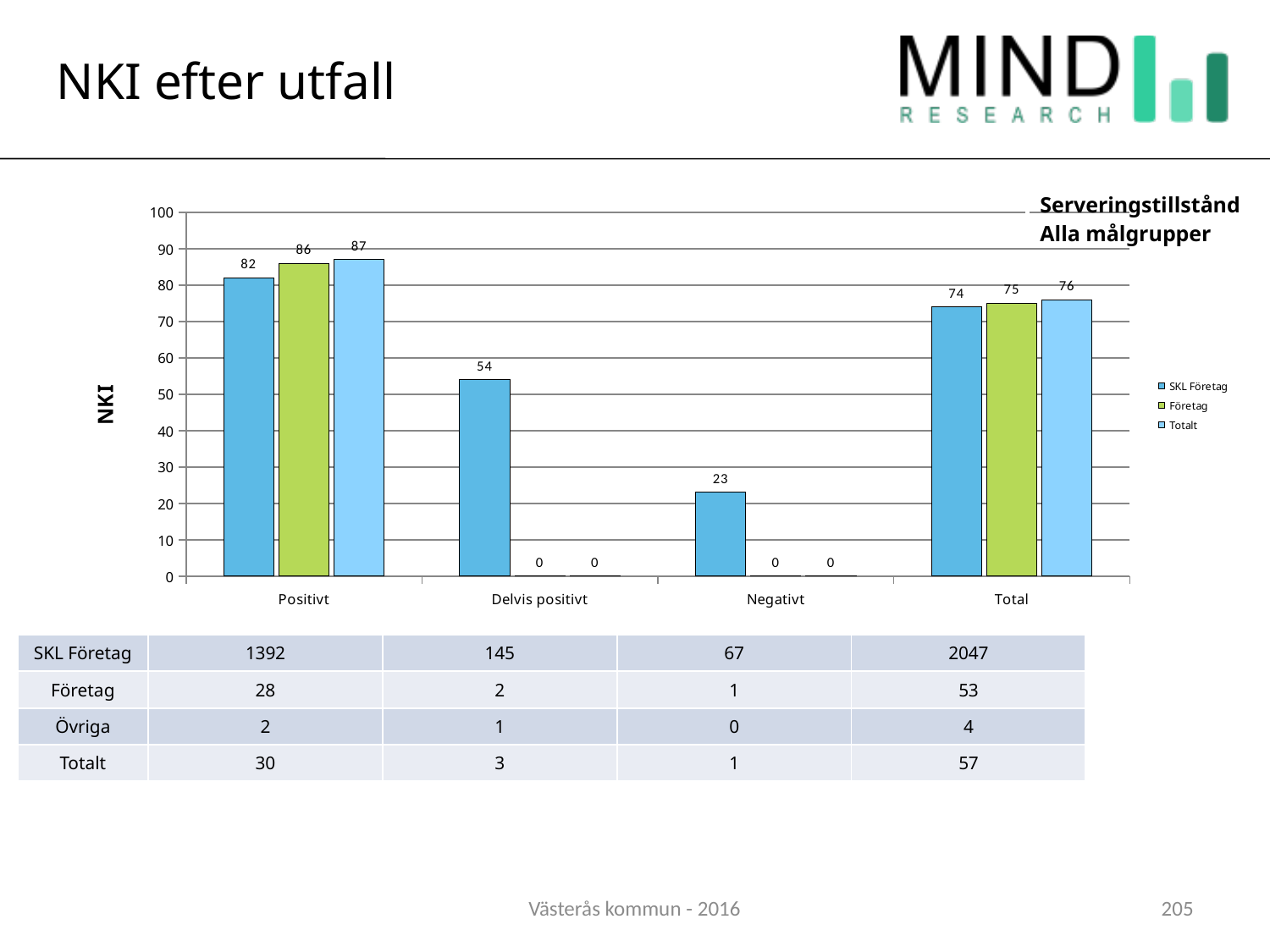
What is the difference between the Totalt value for Positivt and the Totalt value for Total? 11 What is the NKI value for SKL Företag in the Delvis positivt category? 54 What kind of chart is shown on the slide? bar chart Which is larger: the SKL Företag value for Delvis positivt or the SKL Företag value for Negativt? Delvis positivt What is the NKI value for Totalt in the Total category? 76 Which category has the lowest NKI value for SKL Företag? Negativt What is the NKI value for SKL Företag in the Positivt category? 82 How many categories are shown on the x axis of the chart? 4 How many series does the chart legend list? 3 Which category has the highest NKI value for Företag? Positivt What is the NKI value for Företag in the Negativt category? 0 Is the SKL Företag value for Negativt greater or less than 30? less